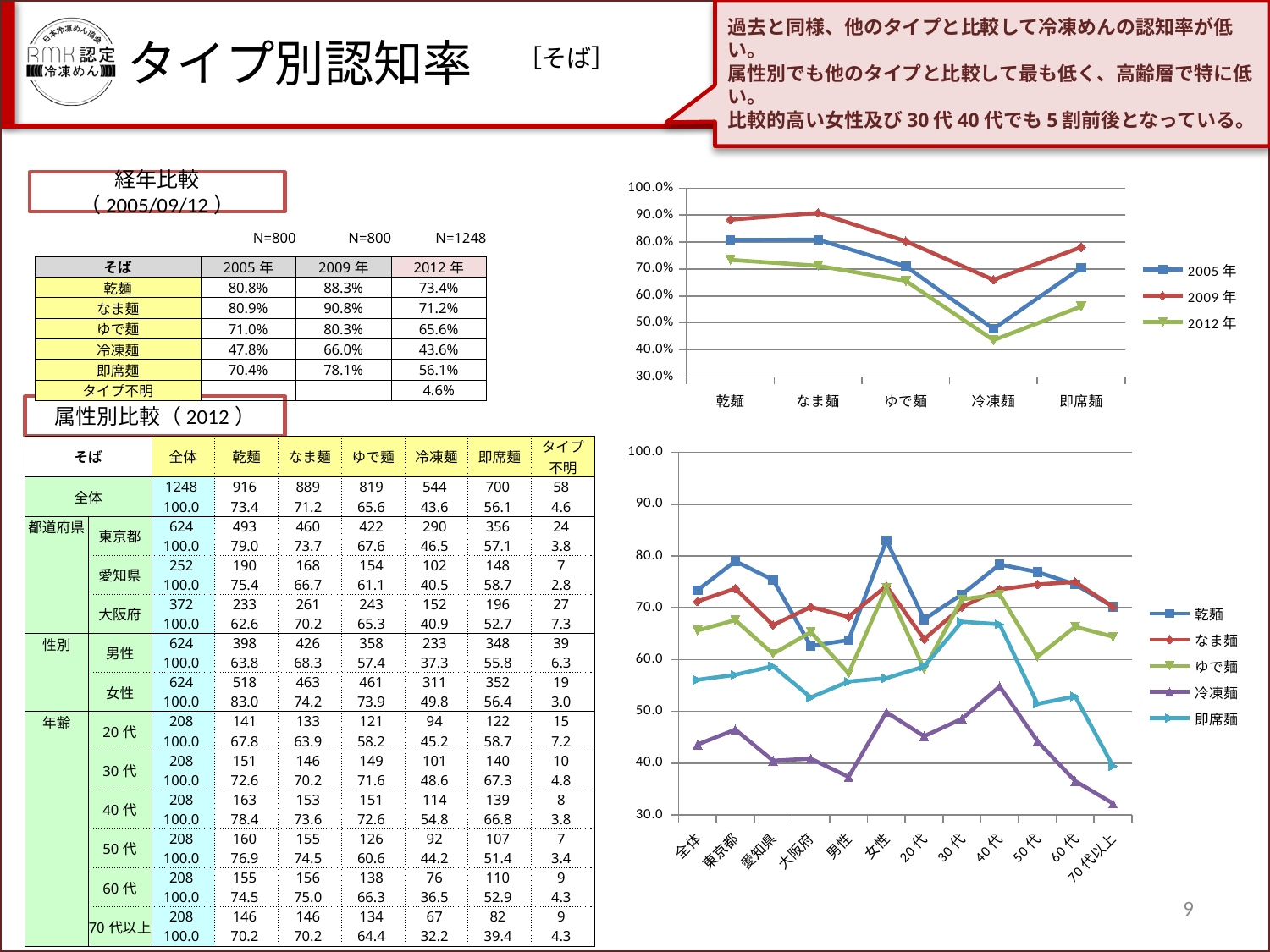
In the upper chart (経年比較), what is the difference between the 2009年 and 2005年 values for なま麺? 9.9% In the upper chart (経年比較), for 即席麺, which series has the larger value, 2009年 or 2012年? 2009年 In the upper chart (経年比較), is the 2005年 value for 乾麺 greater or less than 70.0%? greater What type of chart is the upper chart on the right side of the slide (経年比較)? line chart In the upper chart (経年比較), how many series does the legend list? 3 In the upper chart (経年比較), how many categories are shown on the x axis? 5 In the lower chart (属性別比較), at which category does the 乾麺 series reach its highest value? 女性 In the upper chart (経年比較), which category has the lowest value in the 2012年 series? 冷凍麺 In the lower chart (属性別比較), how many categories are shown on the x axis? 12 In the lower chart (属性別比較), is the 冷凍麺 value for 70代以上 greater or less than 40.0? less In the lower chart (属性別比較), how many series does the legend list? 5 In the upper chart (経年比較), what is the value for 冷凍麺 in the 2009年 series? 66.0%